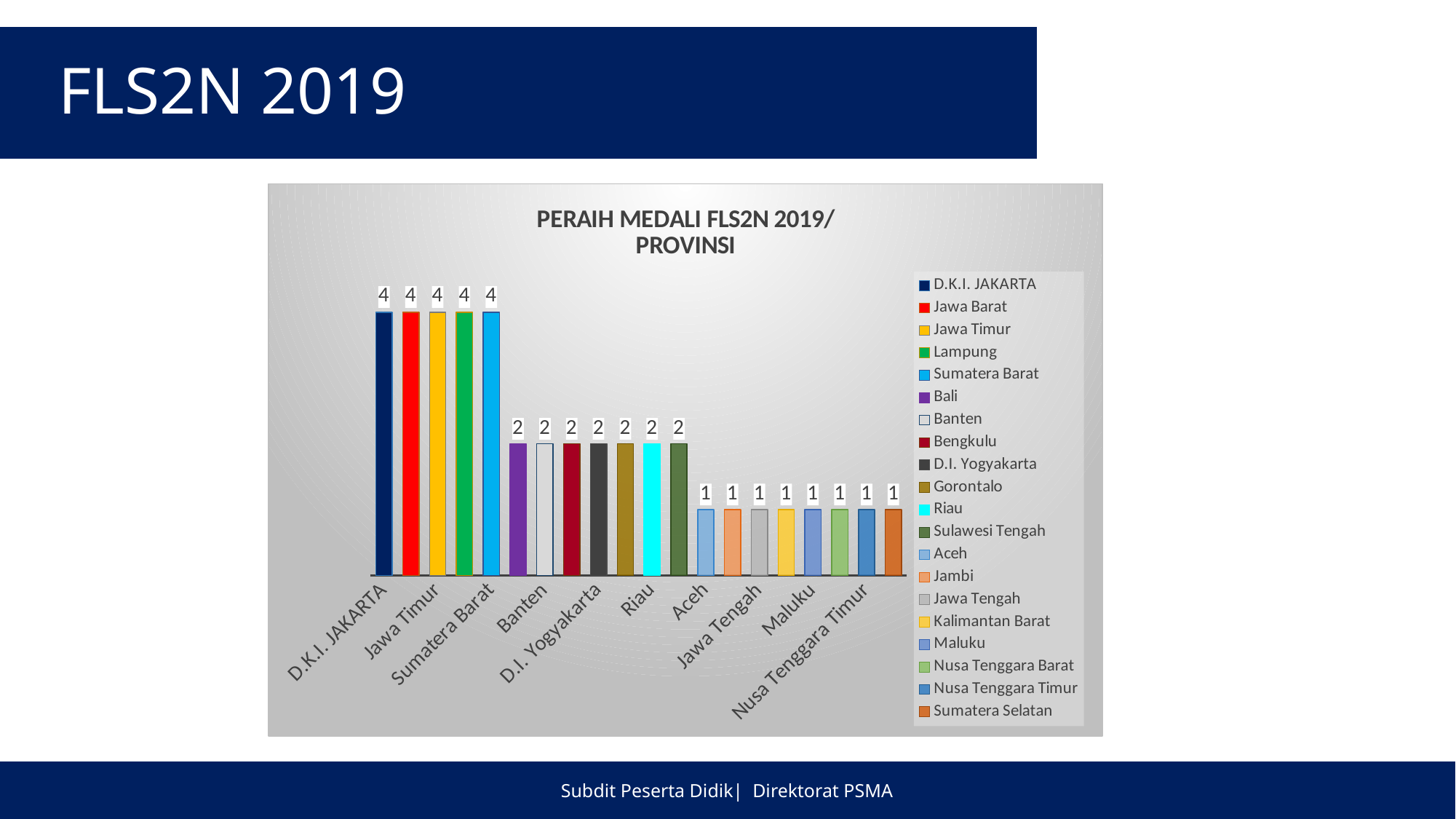
What kind of chart is shown on the slide? Bar chart What is the difference between the values for Sumatera Barat and D.I. Yogyakarta? 2 Which has the larger value, Jawa Timur or Banten? Jawa Timur Which has the larger value, Riau or Maluku? Riau How many bars are plotted in the chart? 20 What is the value for D.K.I. JAKARTA? 4 What is the value for Banten? 2 What is the difference between the values for D.K.I. JAKARTA and Aceh? 3 What is the value for Riau? 2 What is the value for Aceh? 1 How many entries does the legend list? 20 What is the value for Nusa Tenggara Timur? 1